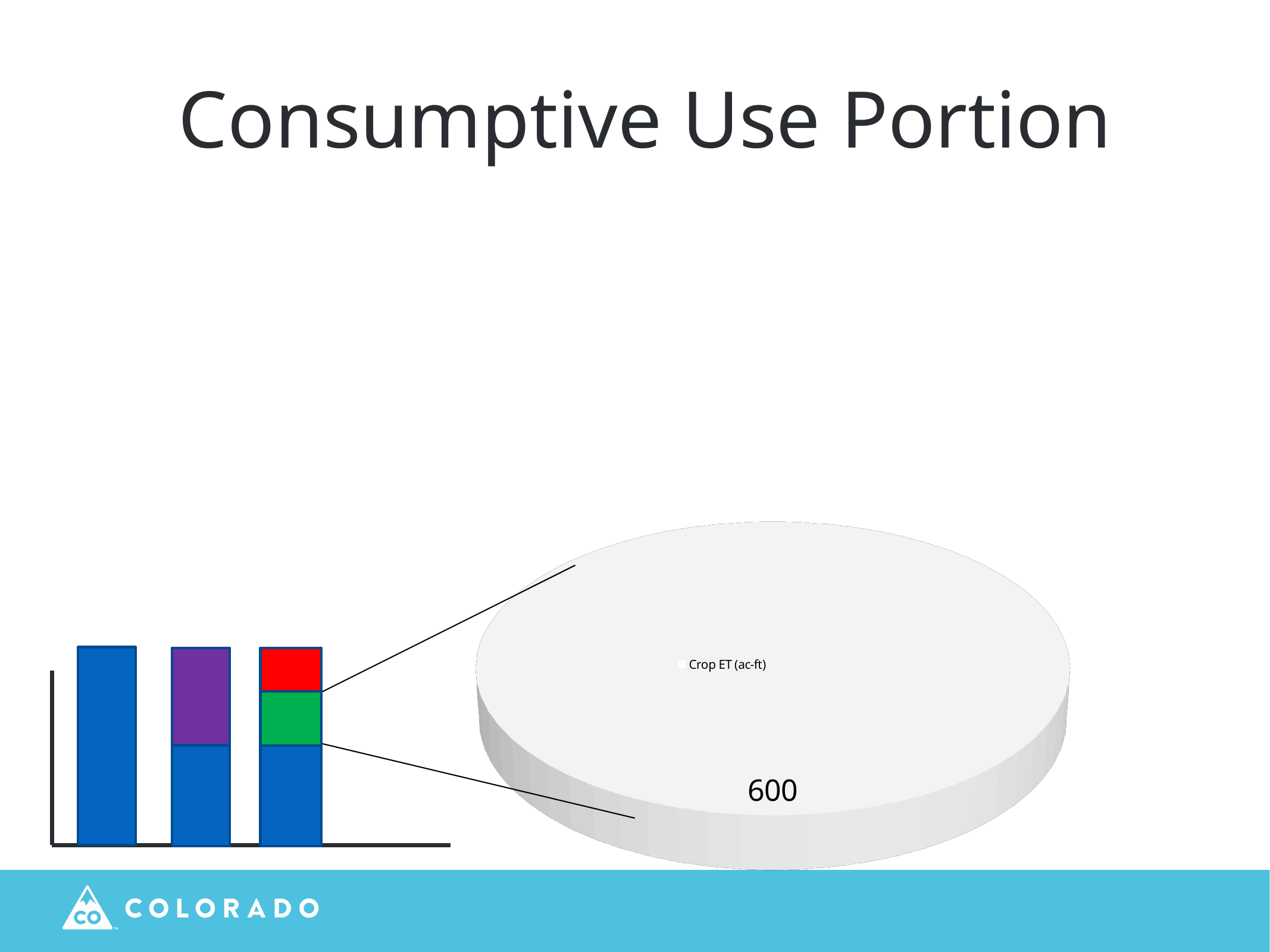
What type of chart is shown on the left side of the slide? bar chart How many bars does the bar chart on the left have? 3 What type of chart is shown on the right side of the slide? pie chart In the pie chart on the right, what is the value for Crop ET (ac-ft)? 600 In the pie chart on the right, what share of the pie does the Crop ET (ac-ft) slice represent? 100% In the pie chart on the right, what value is printed on the slice? 600 What is the legend entry of the pie chart on the right? Crop ET (ac-ft) In the bar chart on the left, how many coloured segments make up the rightmost bar? 3 How many slices does the pie chart on the right have? 1 How many entries does the legend of the pie chart on the right list? 1 What is the title of the slide? Consumptive Use Portion